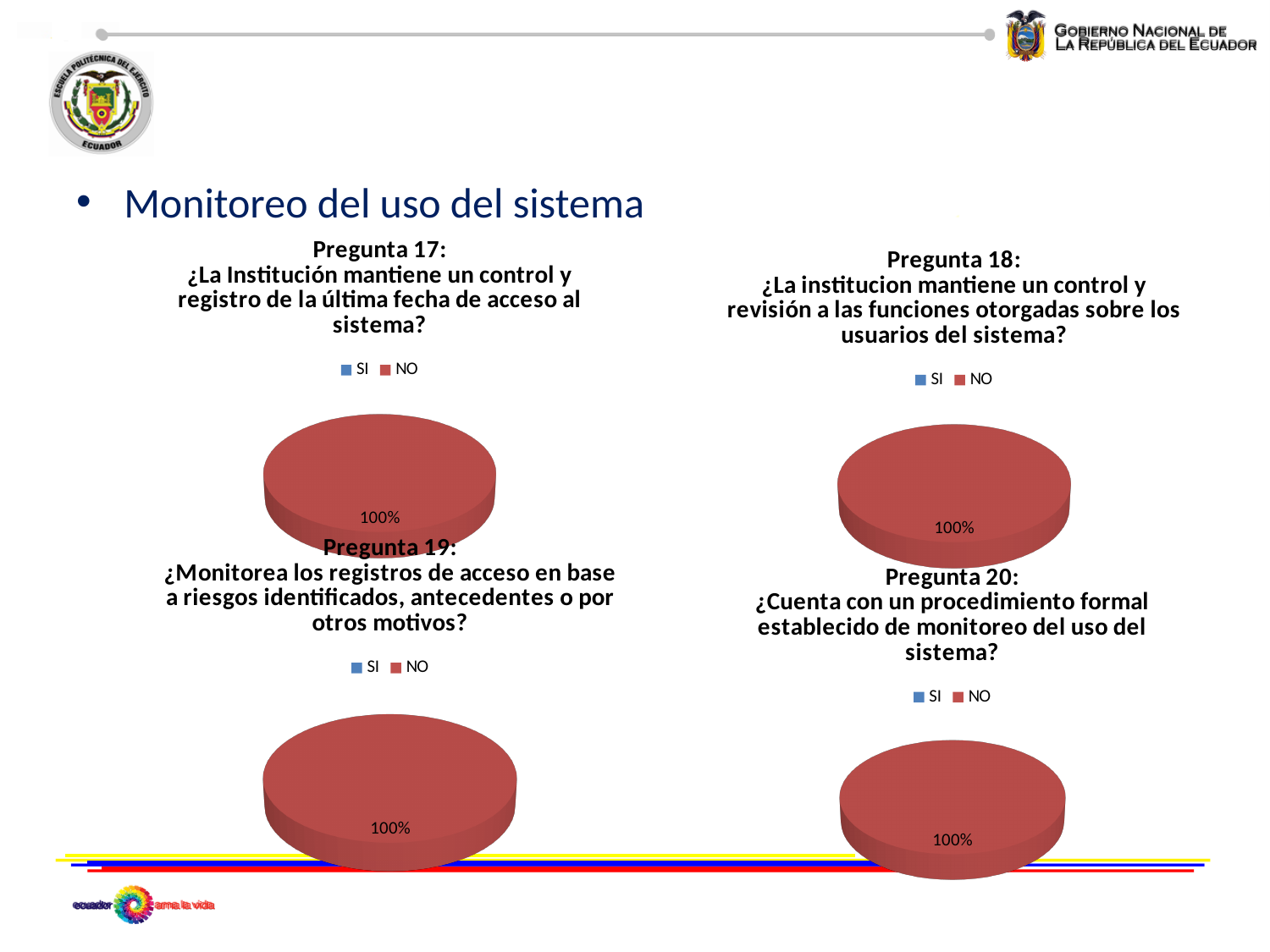
In the Pregunta 20 chart, which legend entry is shown in red? NO In the Pregunta 19 chart, which category makes up the whole pie? NO In the Pregunta 18 chart, which category has the smallest share? SI How many series does the legend of the Pregunta 18 chart list? 2 In the Pregunta 19 chart, which is larger, SI or NO? NO In the Pregunta 20 chart, what share of the pie does NO take? 100% What are the two legend entries in the Pregunta 17 chart? SI and NO How many pie charts are shown on the slide? 4 What kind of chart is used for Pregunta 17? Pie chart In the Pregunta 17 chart, what share of the pie does NO take? 100% In the Pregunta 18 chart, what value is printed on the pie? 100%